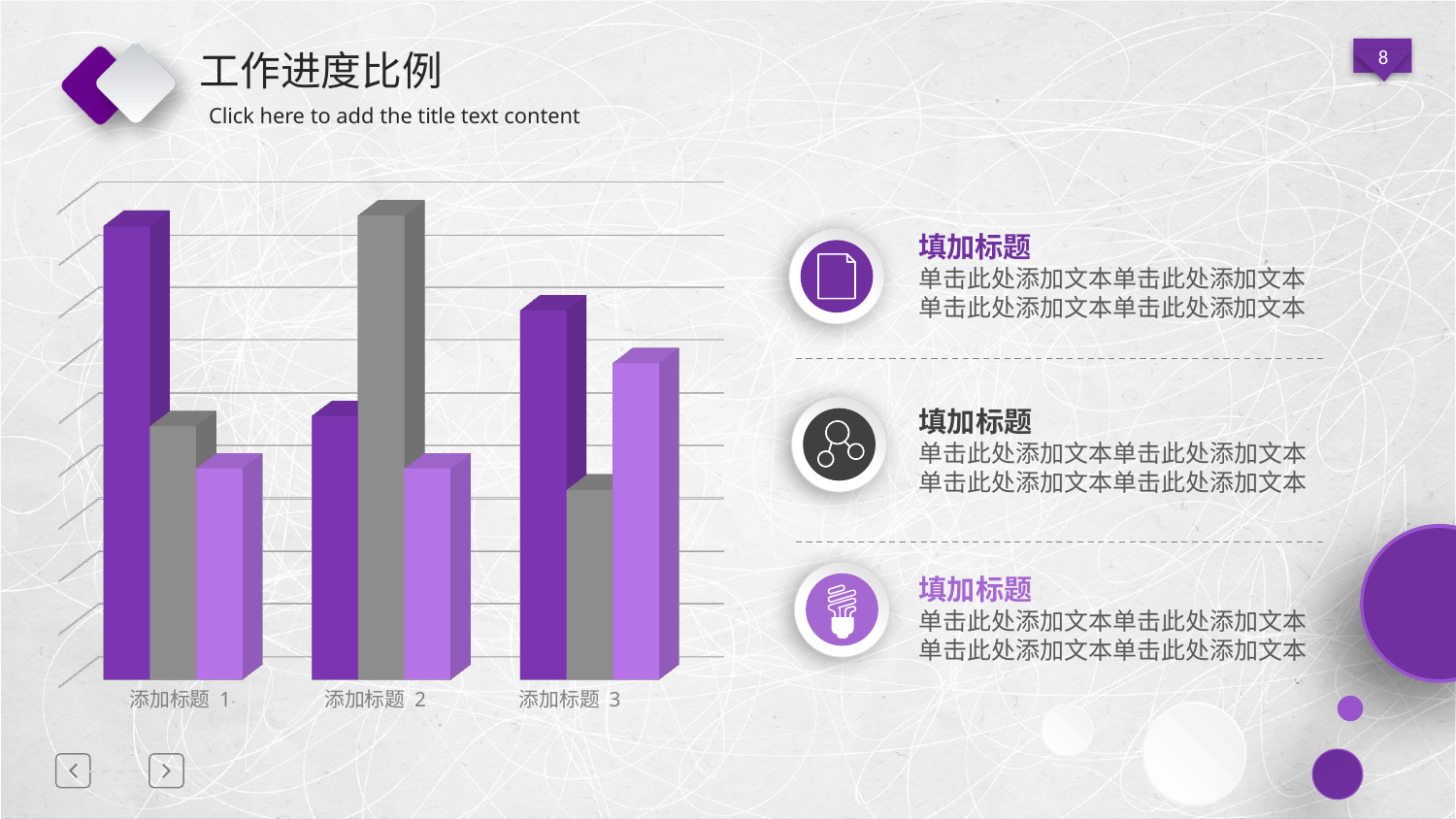
In 添加标题 3, which bar is taller: the gray bar or the light purple bar? the light purple bar How many categories are shown on the x axis of the chart? 3 What kind of chart is shown on the slide? bar chart What is the title of the slide containing the chart? 工作进度比例 Which category has the shortest dark purple bar? 添加标题 2 Which category has the tallest dark purple bar? 添加标题 1 How many bars are plotted for each category in the chart? 3 Which category has the tallest light purple bar? 添加标题 3 Which category has the tallest gray bar? 添加标题 2 Does the gray bar rise or fall from 添加标题 2 to 添加标题 3? fall Which category has the shortest gray bar? 添加标题 3 In 添加标题 2, which bar is taller: the dark purple bar or the gray bar? the gray bar